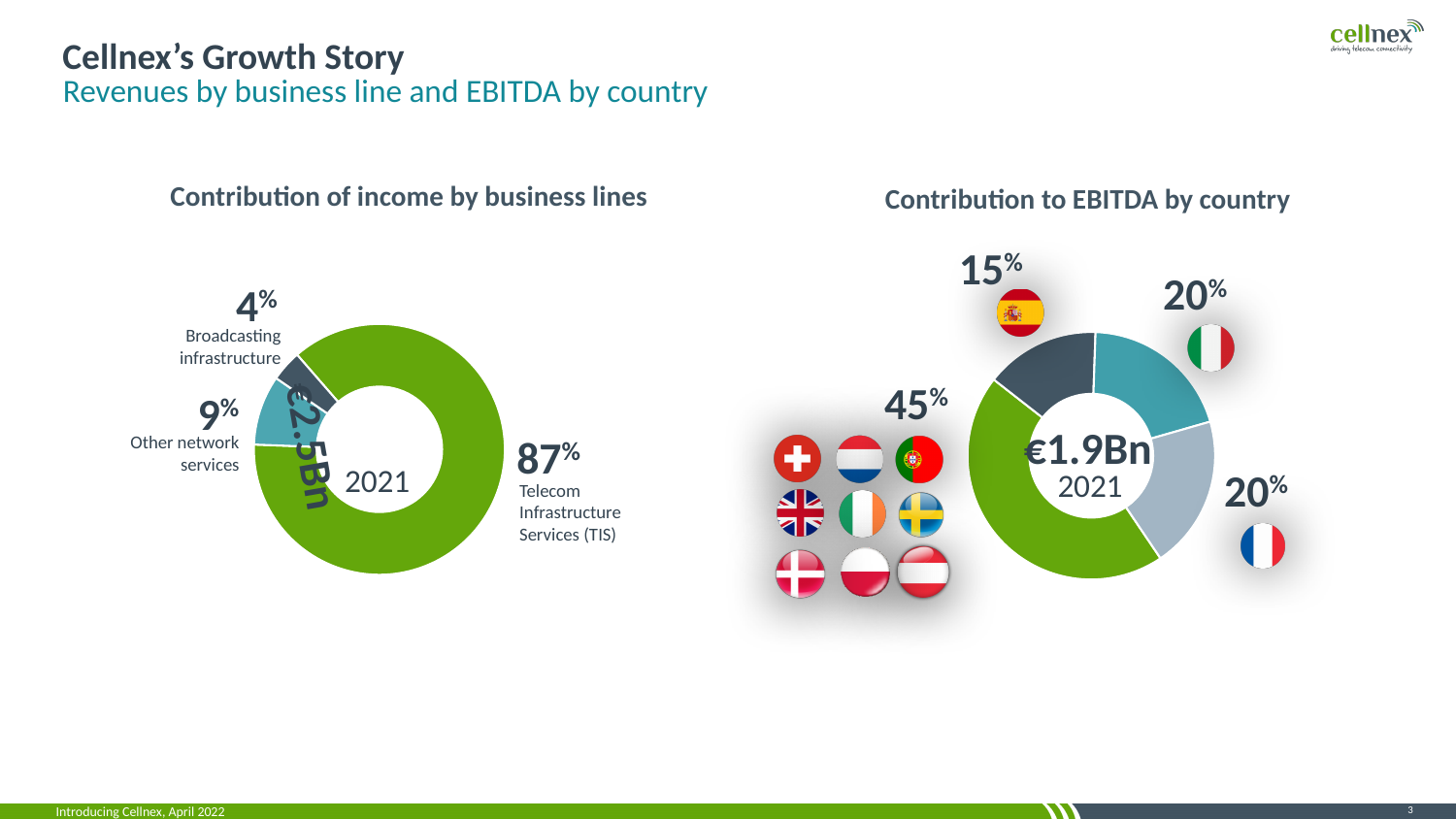
What kind of chart is used for 'Contribution to EBITDA by country'? Donut (pie) chart In the 'Contribution to EBITDA by country' chart, what is the smallest share shown? 15% In the 'Contribution of income by business lines' chart, what share does Broadcasting infrastructure contribute? 4% In the 'Contribution of income by business lines' chart, what share does Telecom Infrastructure Services (TIS) contribute? 87% In the 'Contribution of income by business lines' chart, which business line has the smallest share? Broadcasting infrastructure In the 'Contribution of income by business lines' chart, how many business lines are shown? 3 In the 'Contribution of income by business lines' chart, which business line has the largest share? Telecom Infrastructure Services (TIS) In the 'Contribution to EBITDA by country' chart, how many slices does the donut have? 4 In the 'Contribution to EBITDA by country' chart, what is the largest share shown? 45% In the 'Contribution to EBITDA by country' chart, what total EBITDA value is shown in the centre of the donut? €1.9Bn In the 'Contribution of income by business lines' chart, what is the difference in percentage points between Other network services and Broadcasting infrastructure? 5 In the 'Contribution of income by business lines' chart, what share do Other network services contribute? 9%